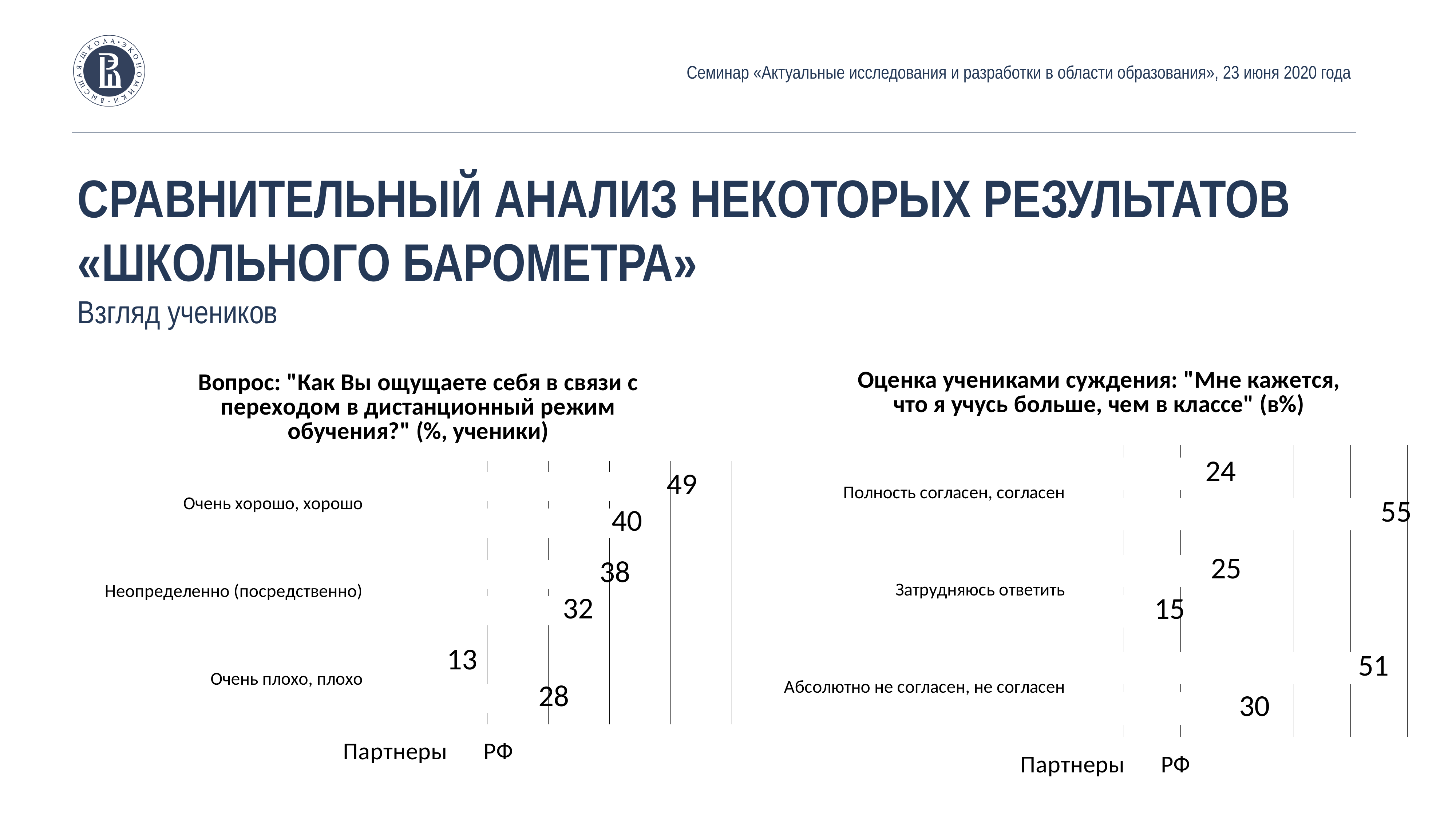
In the left chart ("Как Вы ощущаете себя в связи с переходом в дистанционный режим обучения?"), what are the two values labelled for "Очень плохо, плохо"? 13 and 28 In the left chart ("Как Вы ощущаете себя в связи с переходом в дистанционный режим обучения?"), how many series does the legend list? 2 In the right chart ("Мне кажется, что я учусь больше, чем в классе"), what are the two values labelled for "Абсолютно не согласен, не согласен"? 51 and 30 In the left chart ("Как Вы ощущаете себя в связи с переходом в дистанционный режим обучения?"), how many answer categories are shown? 3 In the left chart ("Как Вы ощущаете себя в связи с переходом в дистанционный режим обучения?"), what are the names of the series in the legend? Партнеры, РФ What type of chart is the right chart ("Мне кажется, что я учусь больше, чем в классе")? Bar chart In the left chart ("Как Вы ощущаете себя в связи с переходом в дистанционный режим обучения?"), what is the largest value labelled for the category "Очень хорошо, хорошо"? 49 How many charts are on the slide? 2 In the right chart ("Мне кажется, что я учусь больше, чем в классе"), what is the difference between the two values labelled for "Полность согласен, согласен"? 31 In the right chart ("Мне кажется, что я учусь больше, чем в классе"), what is the lowest value labelled on the chart? 15 In the right chart ("Мне кажется, что я учусь больше, чем в классе"), what is the highest value labelled on the chart? 55 In the left chart ("Как Вы ощущаете себя в связи с переходом в дистанционный режим обучения?"), what is the difference between the two values labelled for "Неопределенно (посредственно)"? 6